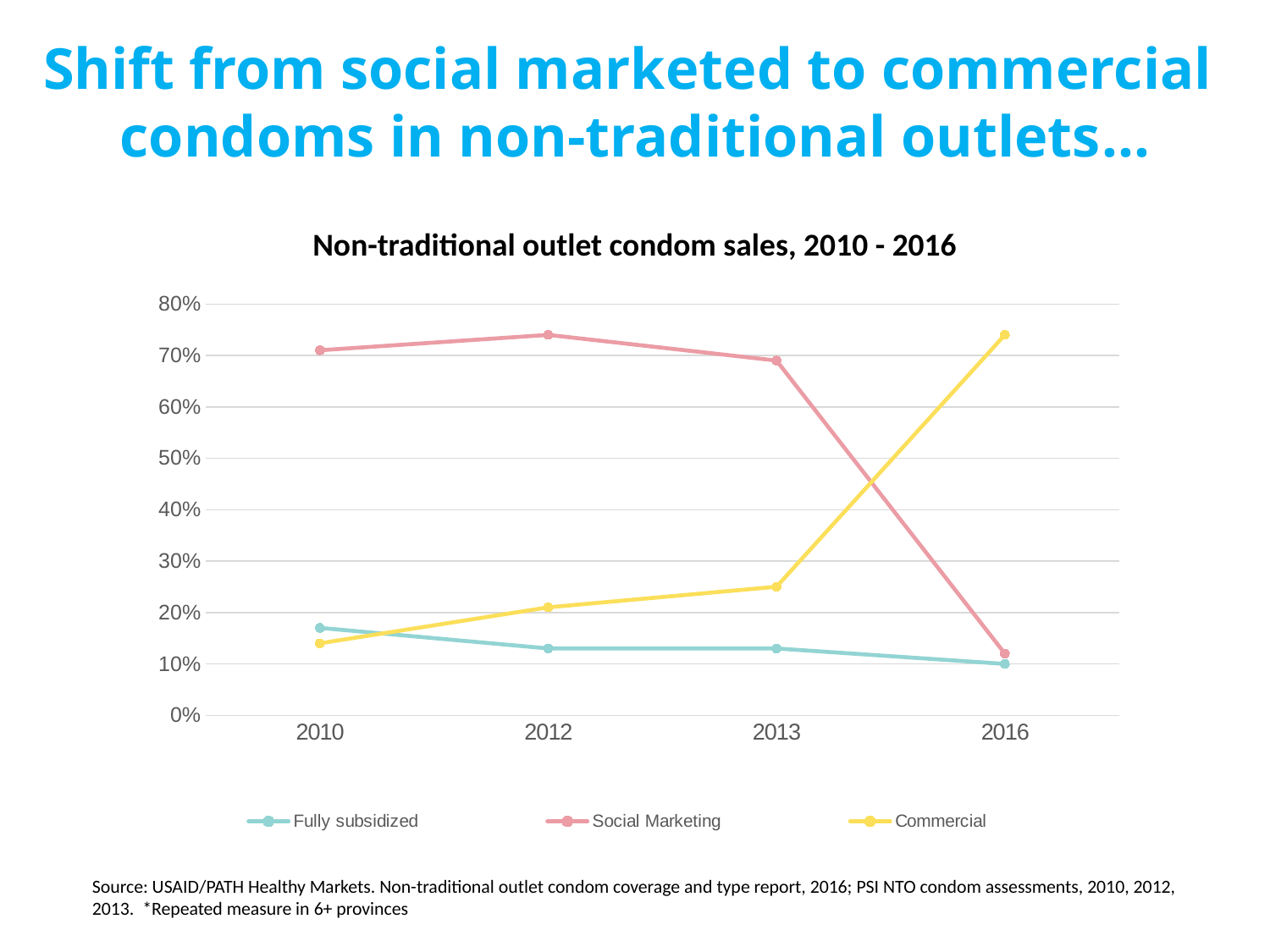
What kind of chart is shown on the slide? line chart How many series does the legend list? 3 Which series has the highest value in 2016? Commercial Does the Commercial series rise or fall from 2010 to 2016? rise Which series has the highest value in 2010? Social Marketing What is the title of the chart? Non-traditional outlet condom sales, 2010 - 2016 How many years are plotted along the x axis? 4 In 2012, which is larger: the value for Commercial or the value for Fully subsidized? Commercial Is the value for Commercial in 2016 greater or less than 70%? greater Is the value for Social Marketing in 2012 greater or less than 70%? greater Which series has the lowest value in 2016? Fully subsidized Is the value for Social Marketing in 2016 greater or less than 20%? less